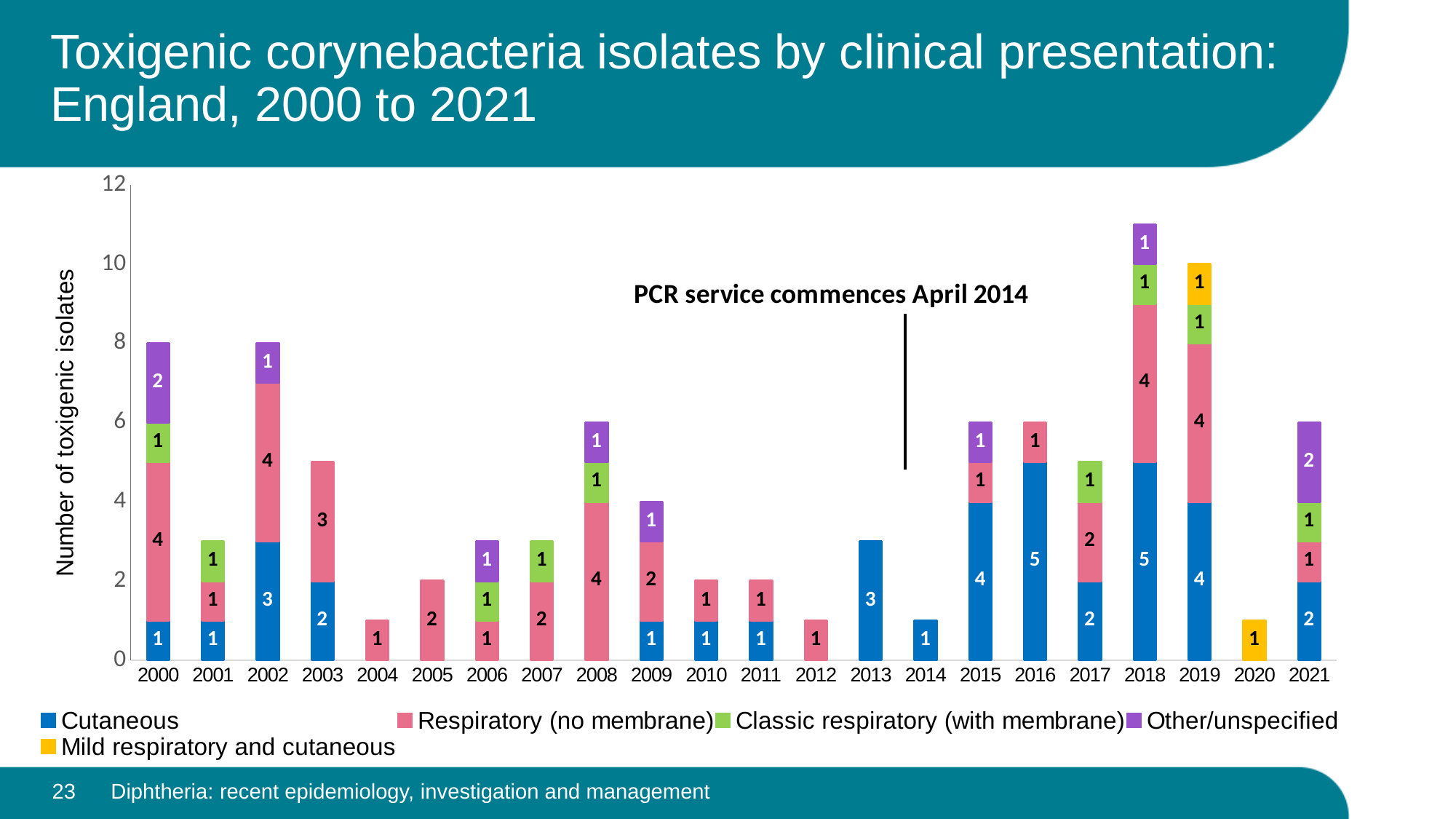
Which year has the highest total number of toxigenic isolates? 2018 What is the total number of toxigenic isolates in 2000? 8 What type of chart is shown on the slide? Stacked bar chart According to the annotation on the chart, when did the PCR service commence? April 2014 What is the number of Respiratory (no membrane) isolates in 2018? 4 Which year has more Cutaneous isolates, 2015 or 2002? 2015 What is the difference between the Cutaneous isolates in 2018 and in 2017? 3 How many years are shown on the x axis? 22 How many series does the legend list? 5 What is the number of Cutaneous isolates in 2016? 5 What is the total number of toxigenic isolates in 2019? 10 What is the number of Other/unspecified isolates in 2021? 2